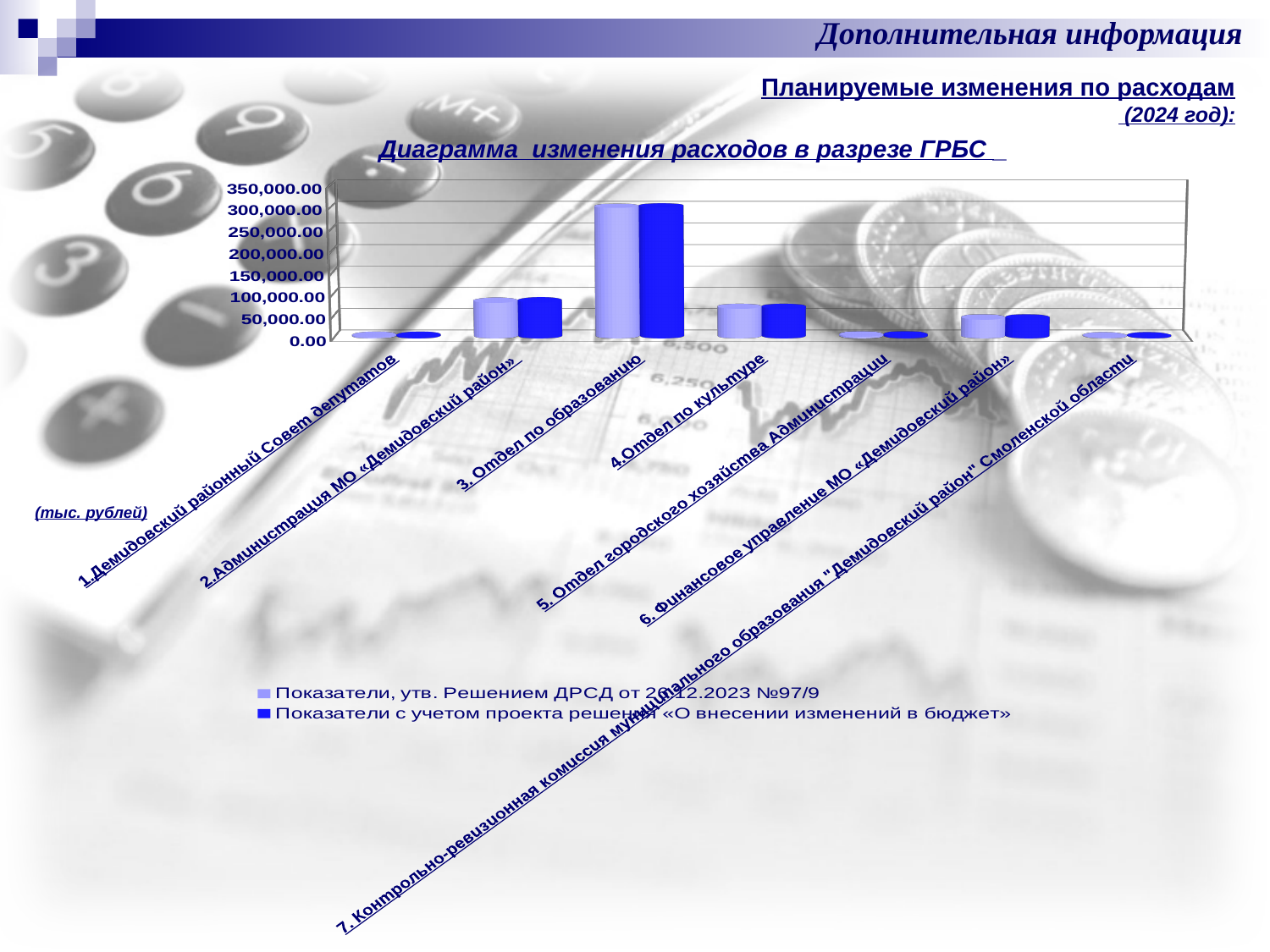
In what units are the chart values given, according to the slide? тыс. рублей Is the value for «3. Отдел по образованию» in the series «Показатели с учетом проекта решения «О внесении изменений в бюджет»» greater or less than 250,000.00? greater Is the value for «4.Отдел по культуре» in the series «Показатели с учетом проекта решения «О внесении изменений в бюджет»» greater or less than 50,000.00? greater How many series does the chart legend list? 2 Which category has the highest bars in the chart? 3. Отдел по образованию What kind of chart is shown on the slide? Bar chart What is the title of the chart? Диаграмма изменения расходов в разрезе ГРБС Is the value for «1.Демидовский районный Совет депутатов» in the series «Показатели, утв. Решением ДРСД от 26.12.2023 №97/9» greater or less than 50,000.00? less Which has the larger value in the series «Показатели с учетом проекта решения «О внесении изменений в бюджет»»: «2.Администрация МО «Демидовский район»» or «4.Отдел по культуре»? 2.Администрация МО «Демидовский район» Which has the larger value in the series «Показатели, утв. Решением ДРСД от 26.12.2023 №97/9»: «3. Отдел по образованию» or «6. Финансовое управление МО «Демидовский район»»? 3. Отдел по образованию How many categories (ГРБС) are shown on the x axis of the chart? 7